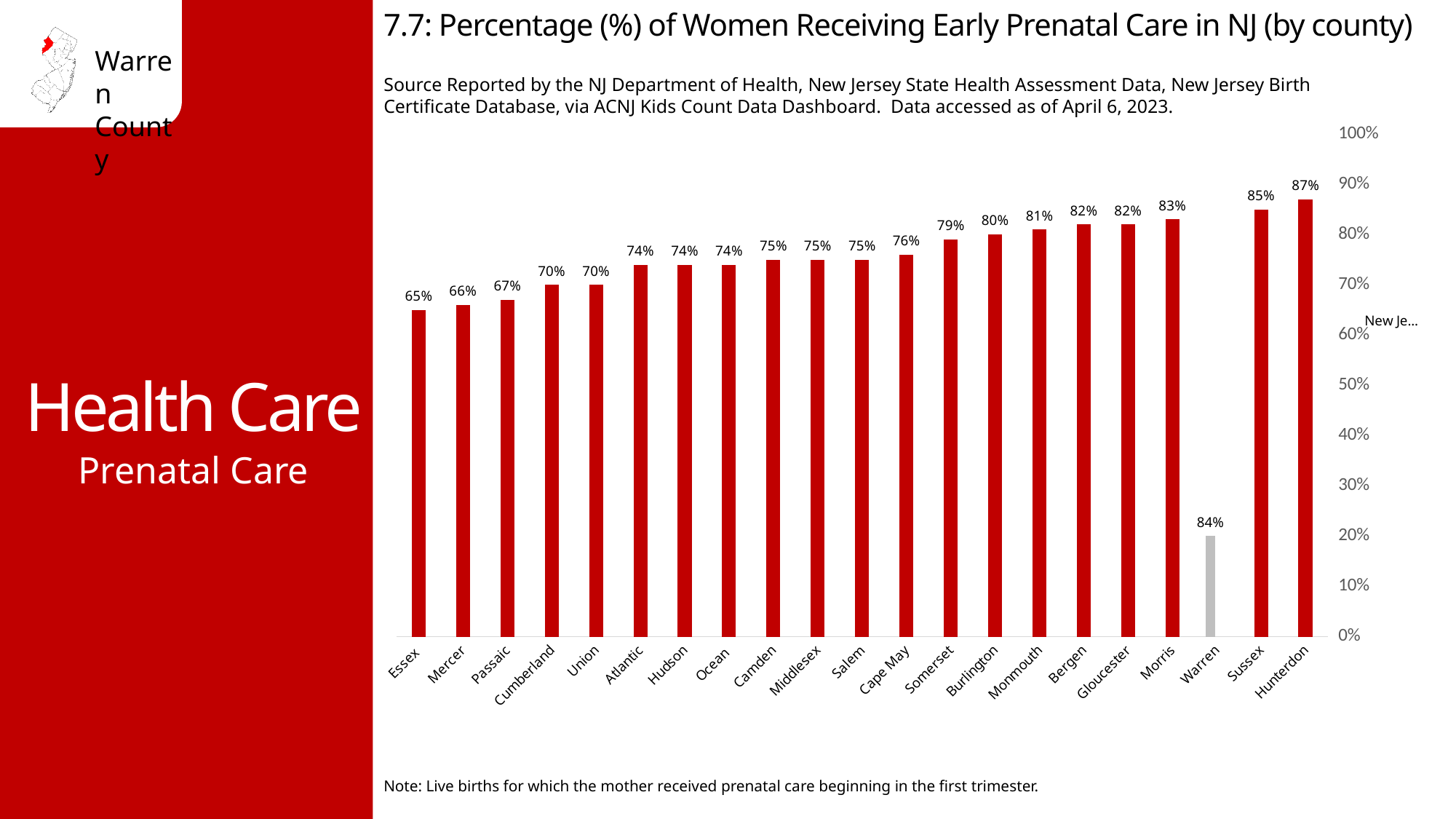
Is the value for Morris greater or less than 80%? greater What is the difference between the values for Hunterdon and Essex? 22 percentage points Which county has the highest percentage of women receiving early prenatal care? Hunterdon What kind of chart is shown on the slide? bar chart What value is labelled for Warren? 84% Which county's bar is shown in gray instead of red? Warren Which has a higher value, Bergen or Cumberland? Bergen How many counties are shown on the x axis? 21 What is the value for Somerset? 79% What is the value for Hunterdon? 87% Do the labelled values generally rise or fall from left to right along the x axis? rise What is the value for Essex? 65%